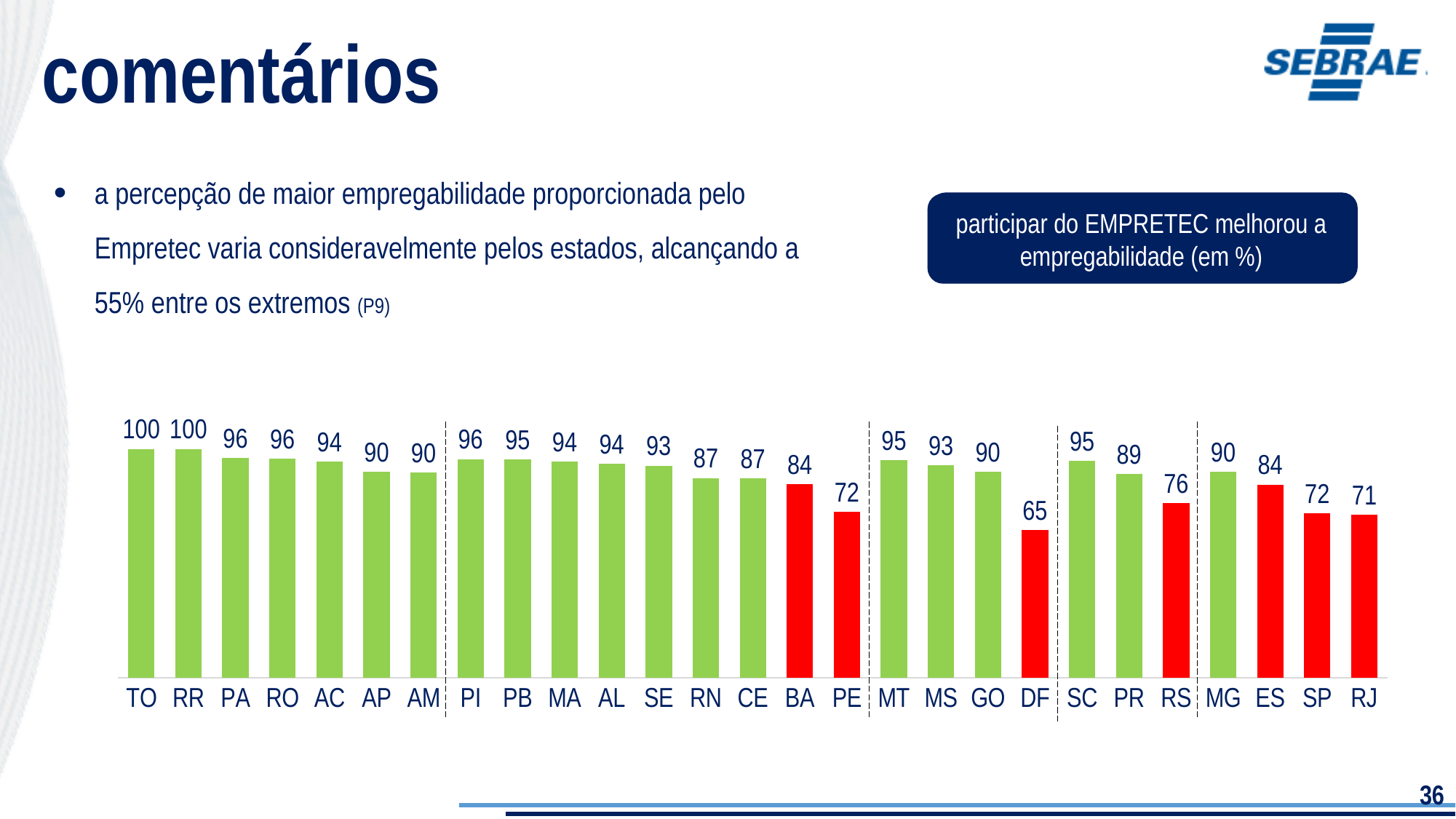
What is the difference between the values for TO and DF? 35 Which state has the lowest value? DF What is the value for SC? 95 Which is larger, the value for PR or the value for MG? MG What is the difference between the values for RS and ES? 8 How many states are shown on the x axis? 27 What is the value for RJ? 71 What is the title shown in the box above the chart? participar do EMPRETEC melhorou a empregabilidade (em %) Which is larger, the value for BA or the value for RN? RN What is the value for PE? 72 What is the value for DF? 65 What kind of chart is shown? bar chart